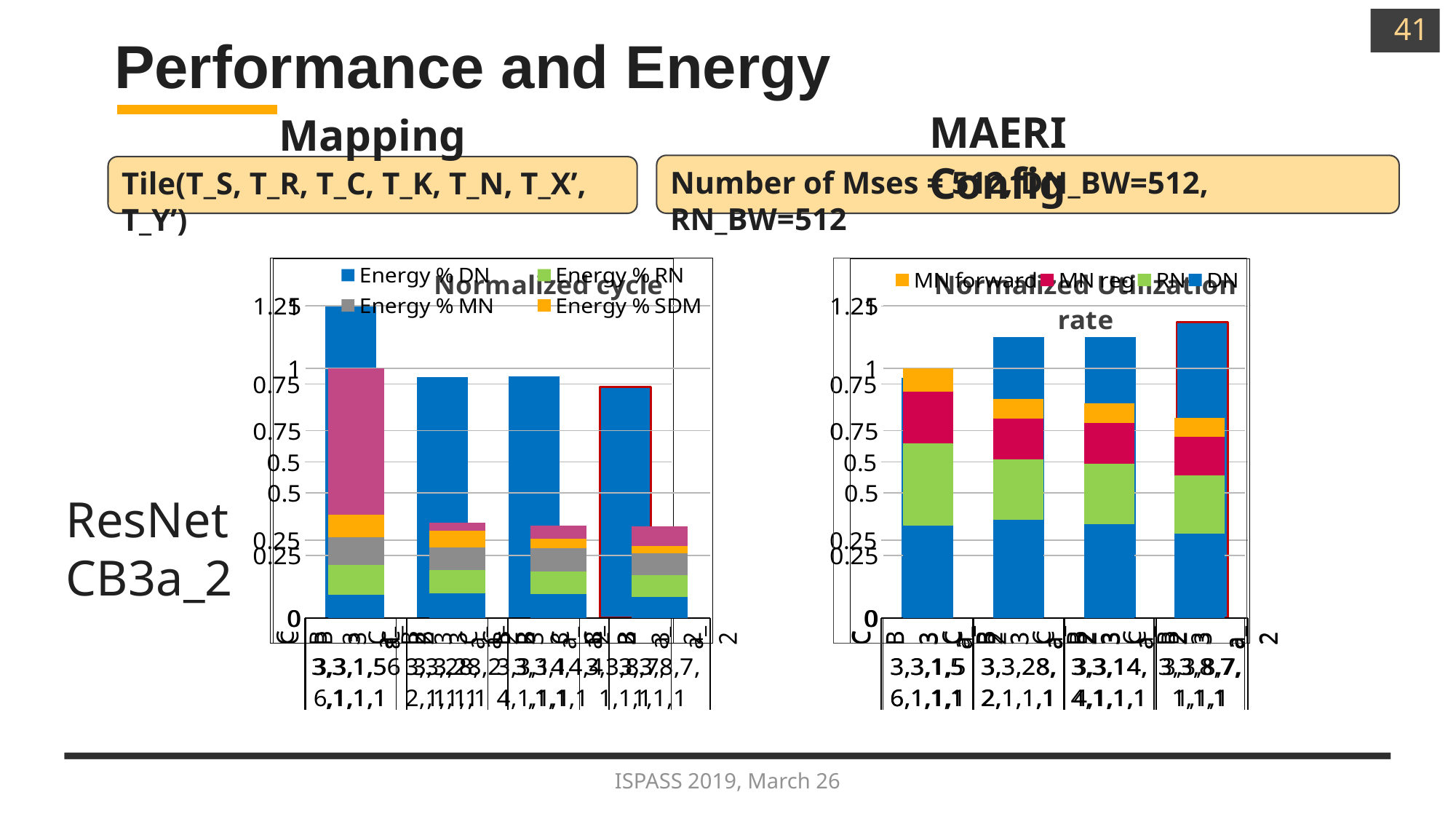
In the right chart (Normalized Utilization rate), how many series does the legend list? 4 What is the title of the chart on the left side of the slide? Normalized cycle What kind of chart is the Normalized cycle chart on the left? bar chart In the left chart (Normalized cycle), which bar is the tallest? the first (leftmost) bar In the left chart (Normalized cycle), how many series does the energy legend list? 4 What kind of chart is the Normalized Utilization rate chart on the right? bar chart What is the title of the chart on the right side of the slide? Normalized Utilization rate